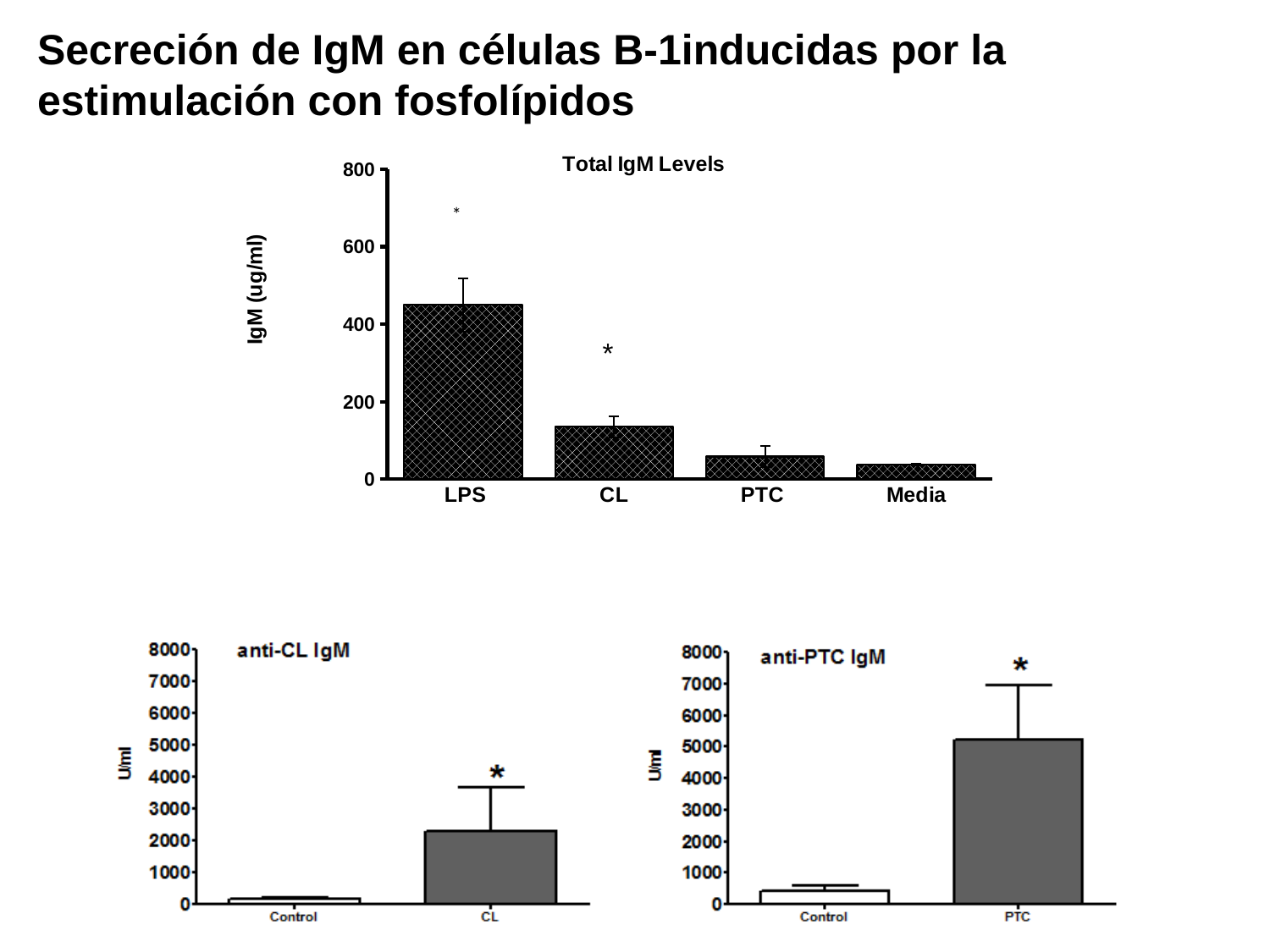
In the anti-PTC IgM chart, is the value for PTC greater or less than 4000? greater In the anti-CL IgM chart, is the value for Control greater or less than 1000? less In the Total IgM Levels chart, is the value for CL greater or less than 200? less What is the y-axis label of the Total IgM Levels chart? IgM (ug/ml) In the Total IgM Levels chart, which category has the highest value? LPS In the Total IgM Levels chart, how many categories are shown on the x axis? 4 In the Total IgM Levels chart, which is larger, the value for CL or the value for PTC? CL In the anti-PTC IgM chart, which category has the higher value, Control or PTC? PTC In the Total IgM Levels chart, which category has the lowest value? Media What kind of chart is the Total IgM Levels chart? bar chart